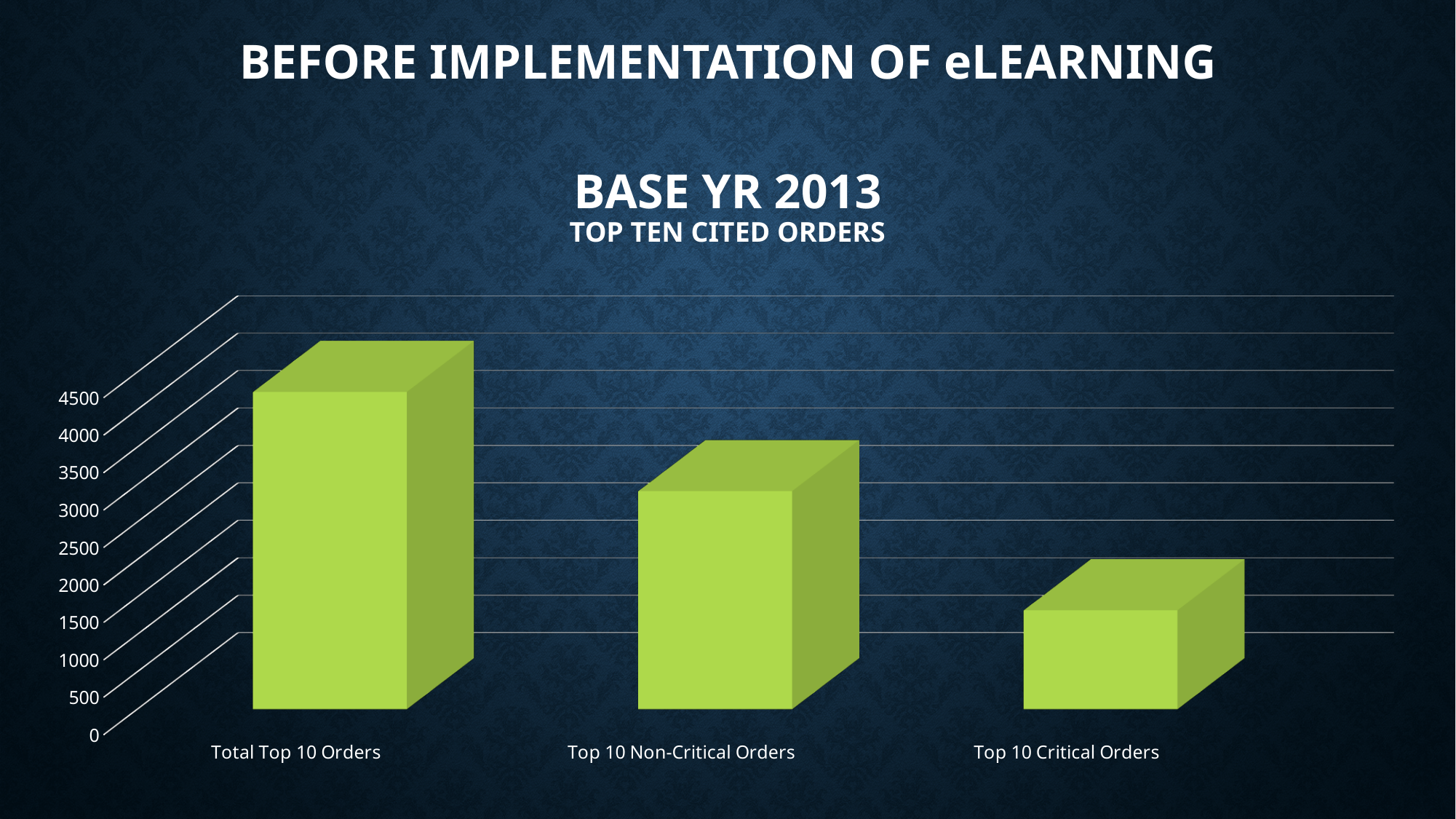
Which category has the lowest value? Top 10 Critical Orders Is the value for Top 10 Non-Critical Orders greater or less than 3500? less What kind of chart is shown on the slide? bar chart Is the value for Top 10 Critical Orders greater or less than 1000? greater Is the value for Top 10 Non-Critical Orders greater or less than 2500? greater Which is larger, Top 10 Non-Critical Orders or Top 10 Critical Orders? Top 10 Non-Critical Orders What is the title of the chart? BASE YR 2013 TOP TEN CITED ORDERS Which category has the highest value? Total Top 10 Orders How many categories are shown on the chart? 3 Do the values rise or fall from left to right across the categories? fall